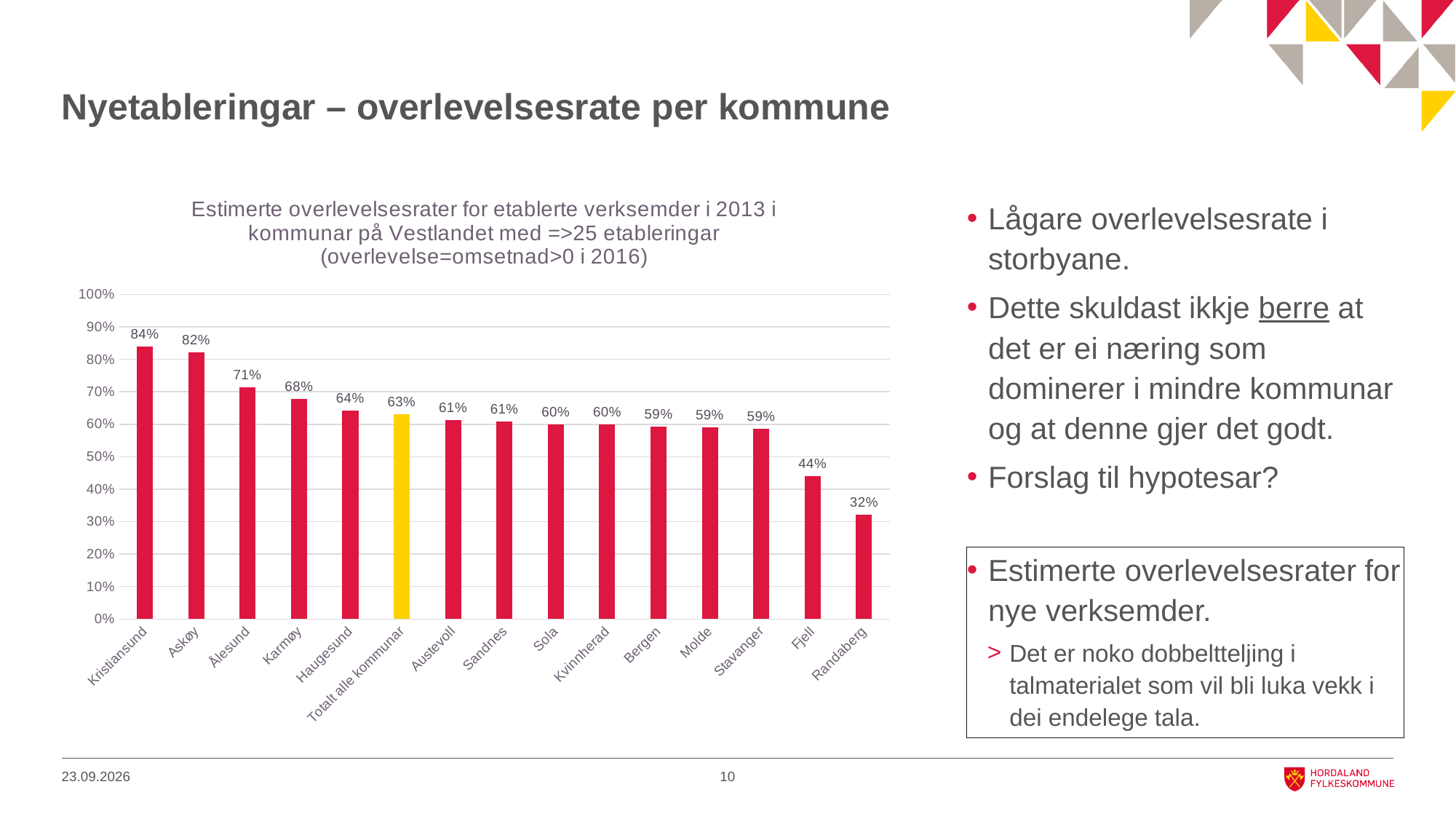
Which has a higher value, Haugesund or Stavanger? Haugesund How many bars are plotted in the chart? 15 Which municipality has the highest survival rate in the chart? Kristiansund What is the value shown for Totalt alle kommunar? 63% What is the value shown for Fjell? 44% What is the difference between the values for Ålesund and Karmøy? 3% Which municipality has the lowest survival rate in the chart? Randaberg Which bar is coloured yellow instead of red? Totalt alle kommunar What is the difference between the values for Kristiansund and Randaberg? 52% What kind of chart is shown on the slide? Bar chart What is the survival rate shown for Kristiansund? 84% What is the value shown for Bergen? 59%